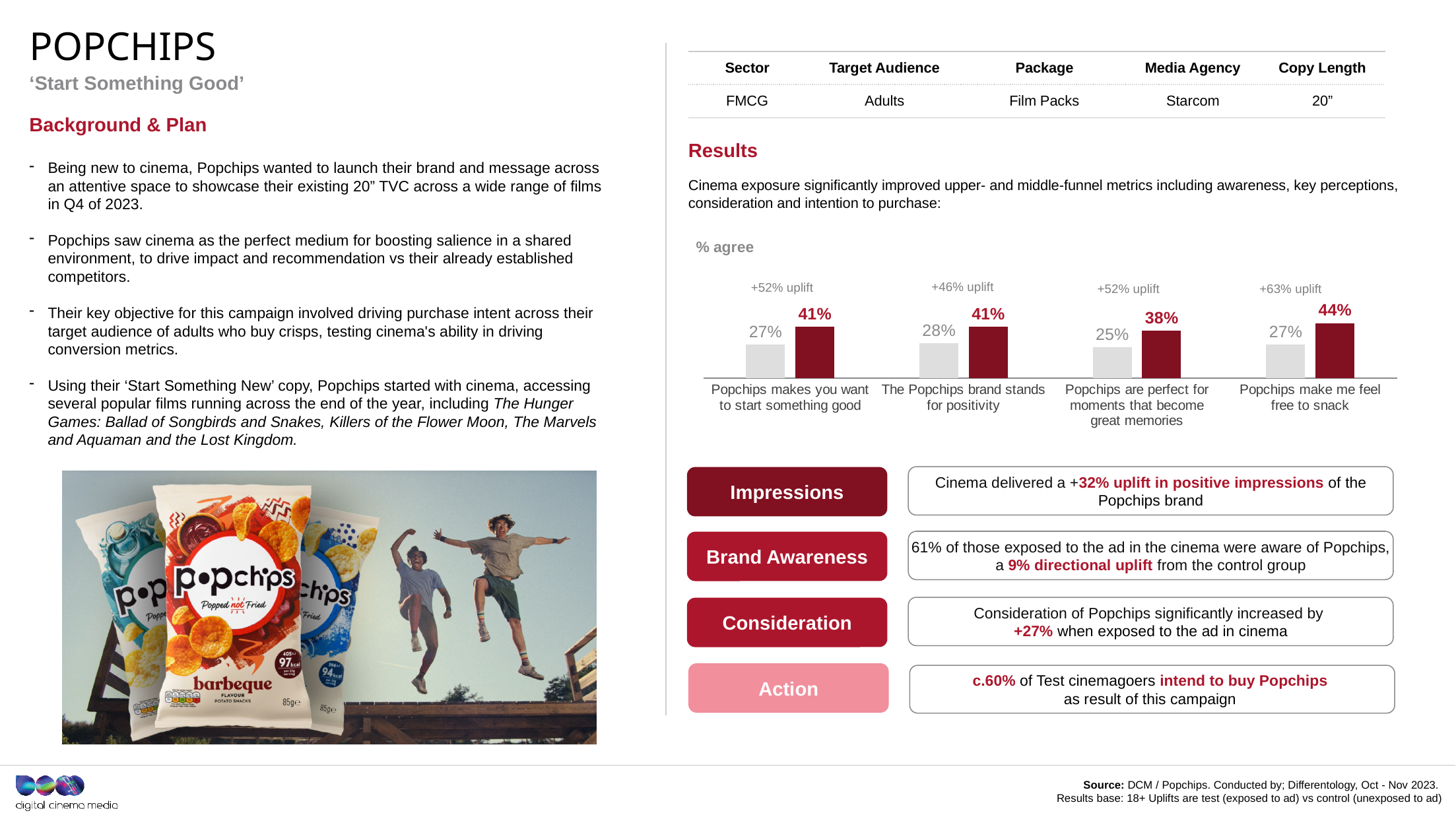
On the '% agree' chart, what uplift is shown above 'The Popchips brand stands for positivity'? +46% uplift On the '% agree' chart, is the red bar for 'Popchips are perfect for moments that become great memories' larger or smaller than the red bar for 'The Popchips brand stands for positivity'? smaller On the '% agree' chart, which statement has the highest red bar value? Popchips make me feel free to snack On the '% agree' chart, which statement has the lowest grey bar value? Popchips are perfect for moments that become great memories On the '% agree' chart, what is the value of the grey bar for 'The Popchips brand stands for positivity'? 28% On the '% agree' chart, what is the difference between the red and grey bars for 'Popchips makes you want to start something good'? 14% On the '% agree' chart, what uplift is shown above 'Popchips make me feel free to snack'? +63% uplift How many statements (categories) are shown on the '% agree' chart? 4 On the '% agree' chart, what is the value of the grey bar for 'Popchips are perfect for moments that become great memories'? 25% What type of chart is shown under the '% agree' heading? bar chart On the '% agree' chart, what is the difference between the red and grey bars for 'Popchips make me feel free to snack'? 17% On the '% agree' chart, what is the value of the red bar for 'Popchips make me feel free to snack'? 44%